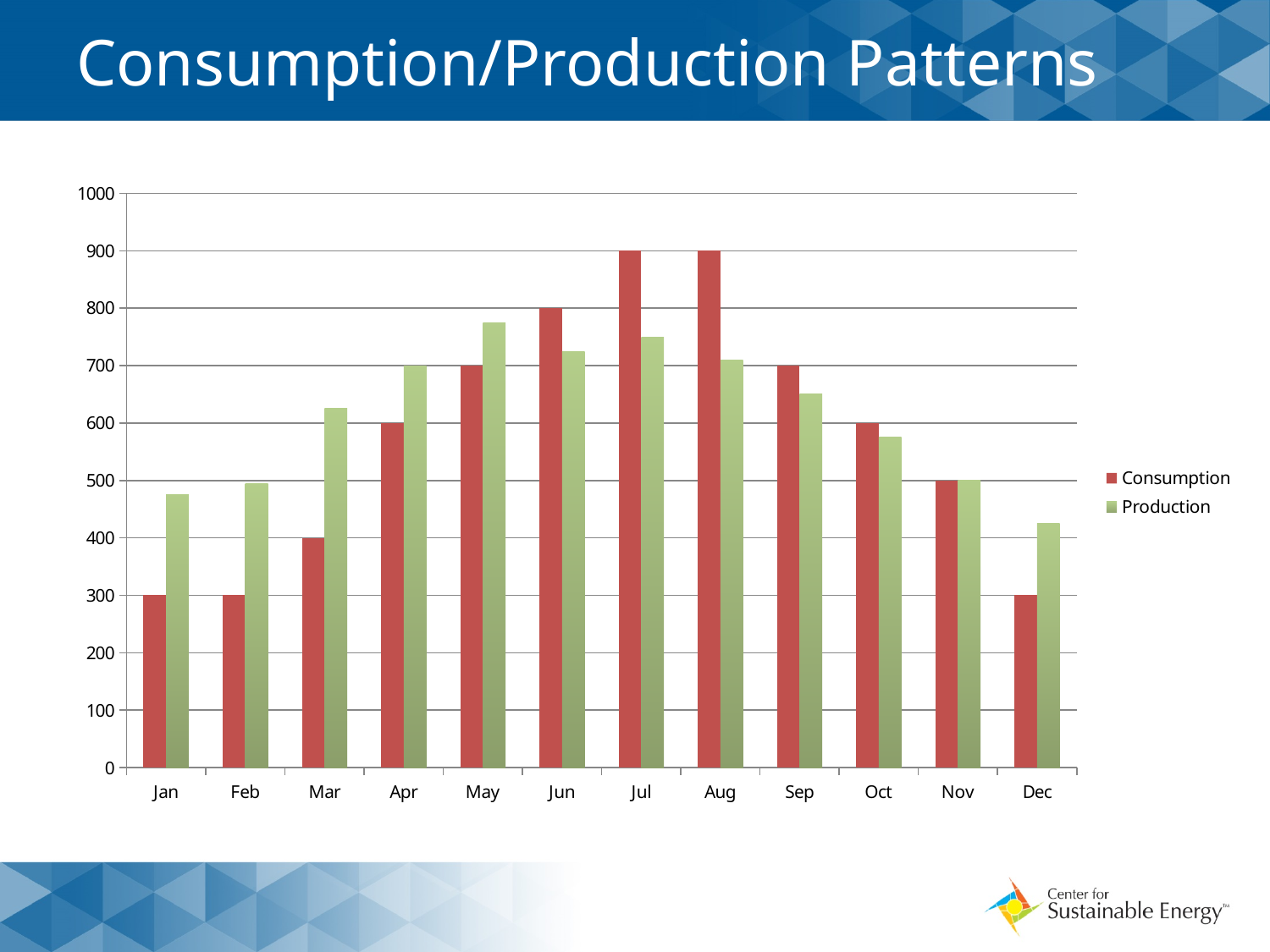
How many series does the legend list? 2 What is the difference between the Consumption values for Jul and Jan? 600 Which month has the highest Production value? May What is the Consumption value for Jan? 300 Does the Consumption value rise or fall from Jan to Jul? rise How many months are shown on the x axis? 12 In Aug, which is larger, Consumption or Production? Consumption Is the Production value for Jan greater or less than 500? less What is the Production value for Apr? 700 In Jan, which is larger, Consumption or Production? Production Is the Production value for Mar greater or less than 600? greater What is the Consumption value for Jul? 900